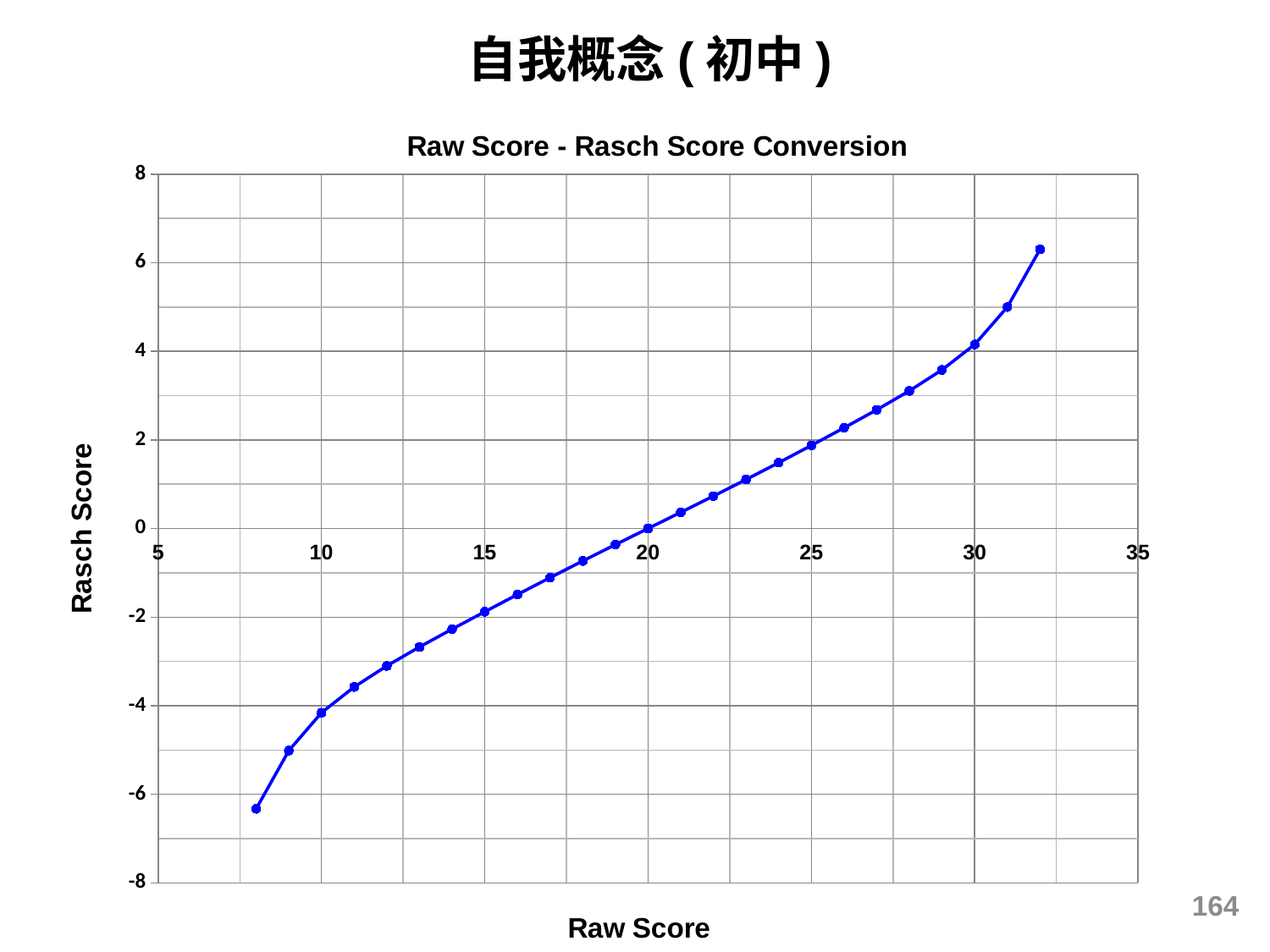
Is the Rasch Score at a Raw Score of 8 greater or less than -6? less What is the title of the chart? Raw Score - Rasch Score Conversion Is the Rasch Score at a Raw Score of 12 greater or less than -2? less What is the label of the vertical axis? Rasch Score What is the Rasch Score at a Raw Score of 20? 0 Do the Rasch Score values rise or fall as the Raw Score increases? Rise Is the Rasch Score at a Raw Score of 32 greater or less than 6? greater At which Raw Score is the Rasch Score highest? 32 How many data points are plotted on the line? 25 What kind of chart is shown on the slide? Line chart Which has the larger Rasch Score, a Raw Score of 24 or a Raw Score of 14? 24 At which Raw Score is the Rasch Score lowest? 8